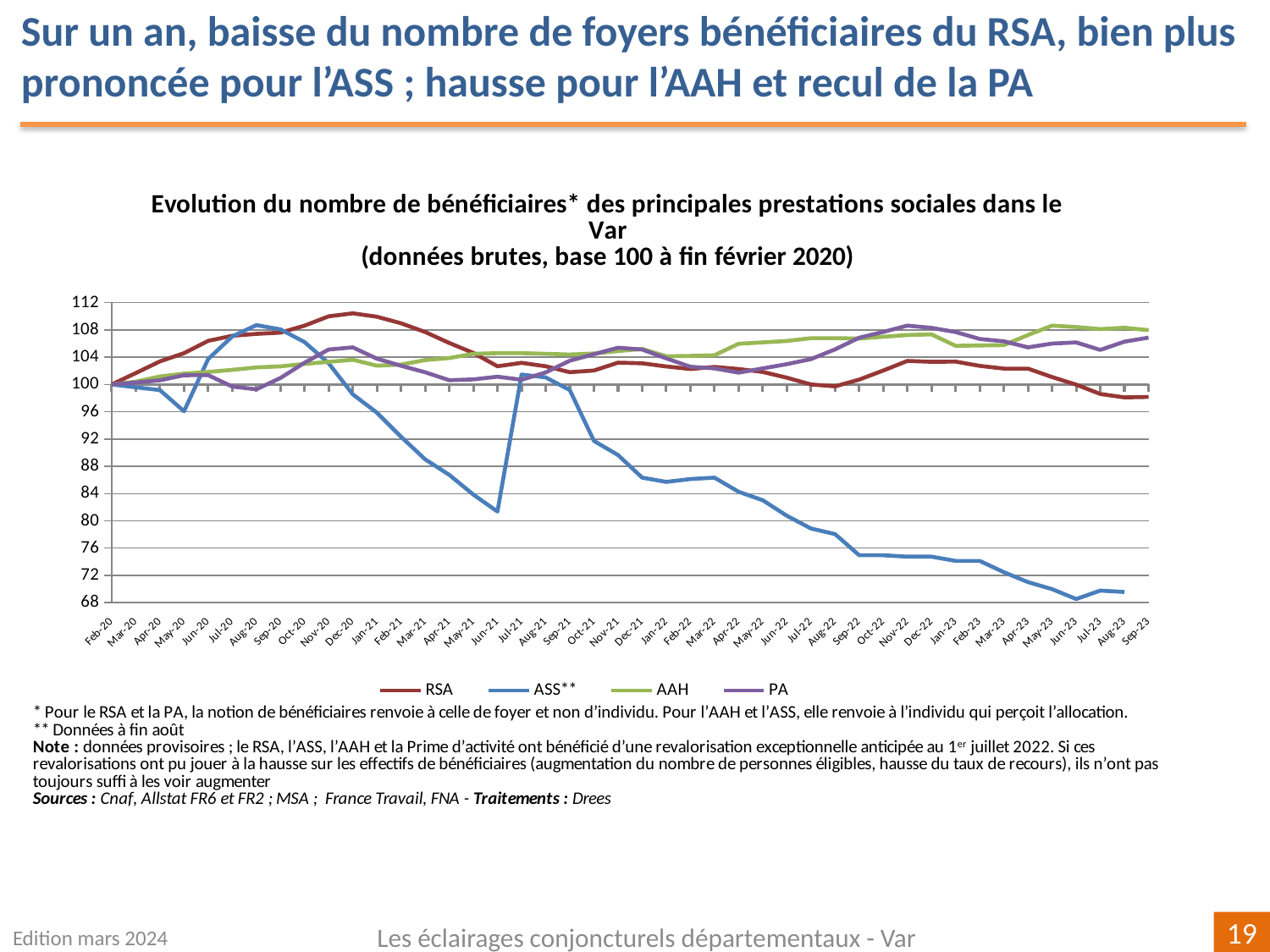
Which series is drawn in purple in the legend? PA Is the value for RSA at Dec-20 greater or less than 108? greater What is the value of all four series at Feb-20, the base month? 100 What kind of chart is shown on the slide? line chart Does the ASS** series rise or fall between Jul-21 and Sep-23? fall Which series is the lowest at Sep-23? RSA Is the value for RSA at Sep-23 greater or less than 100? less Which series is the highest at Dec-20? RSA At Sep-23, which is larger, the value for AAH or the value for RSA? AAH How many series does the legend list? 4 Is the value for AAH at Sep-23 greater or less than 104? greater